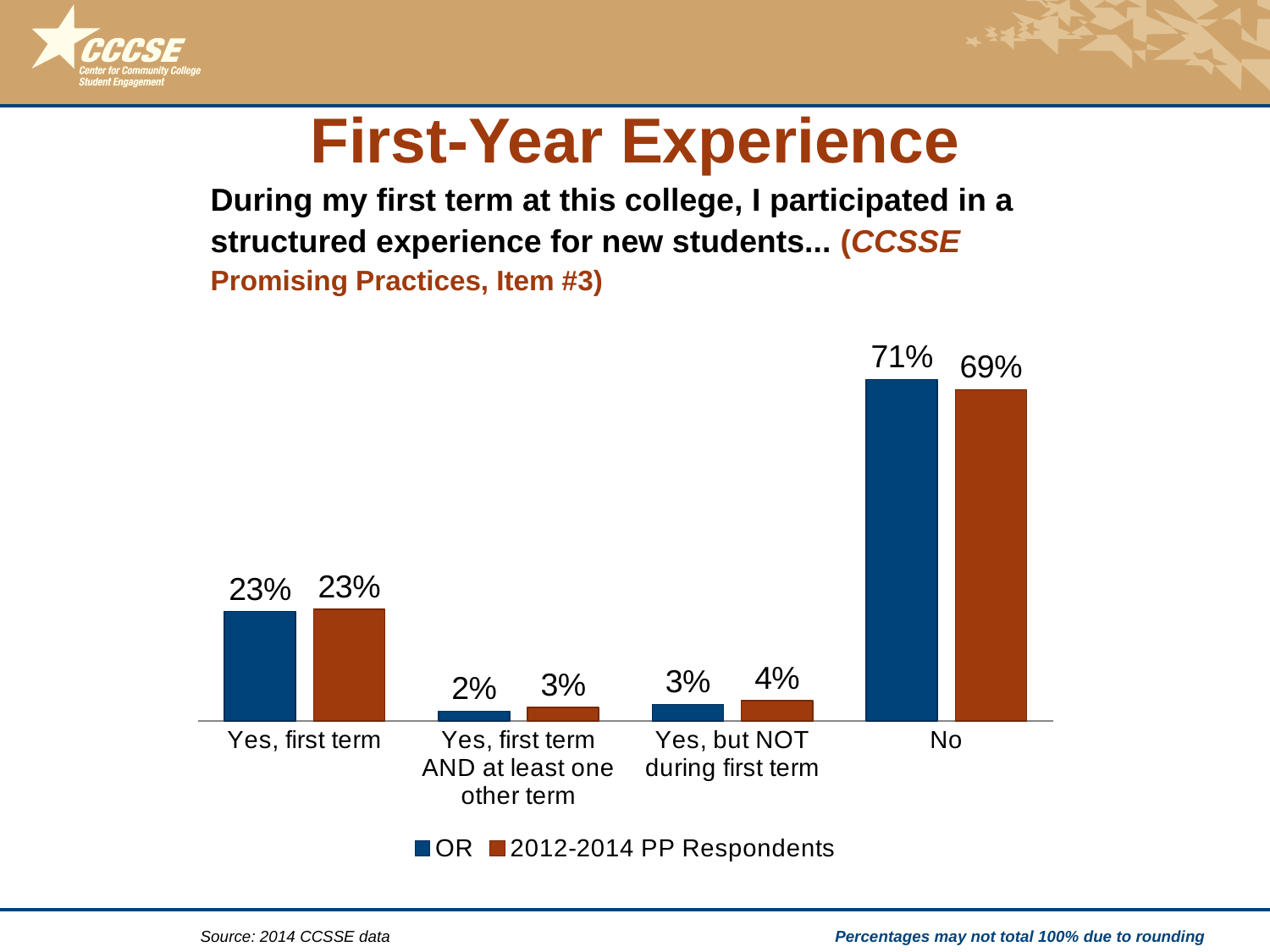
Which category has the highest value for the OR series? No How many series does the legend list? 2 What is the value for OR in the "Yes, but NOT during first term" category? 3% What is the value for OR in the "No" category? 71% In the "Yes, but NOT during first term" category, which series has the larger value, OR or 2012-2014 PP Respondents? 2012-2014 PP Respondents What is the value for 2012-2014 PP Respondents in the "Yes, first term AND at least one other term" category? 3% What kind of chart is shown on the slide? Bar chart Which category has the lowest value for the OR series? Yes, first term AND at least one other term What are the two series listed in the legend? OR and 2012-2014 PP Respondents How many categories are shown on the x axis? 4 What is the difference between the OR and 2012-2014 PP Respondents values in the "No" category? 2% What is the value for 2012-2014 PP Respondents in the "Yes, first term" category? 23%